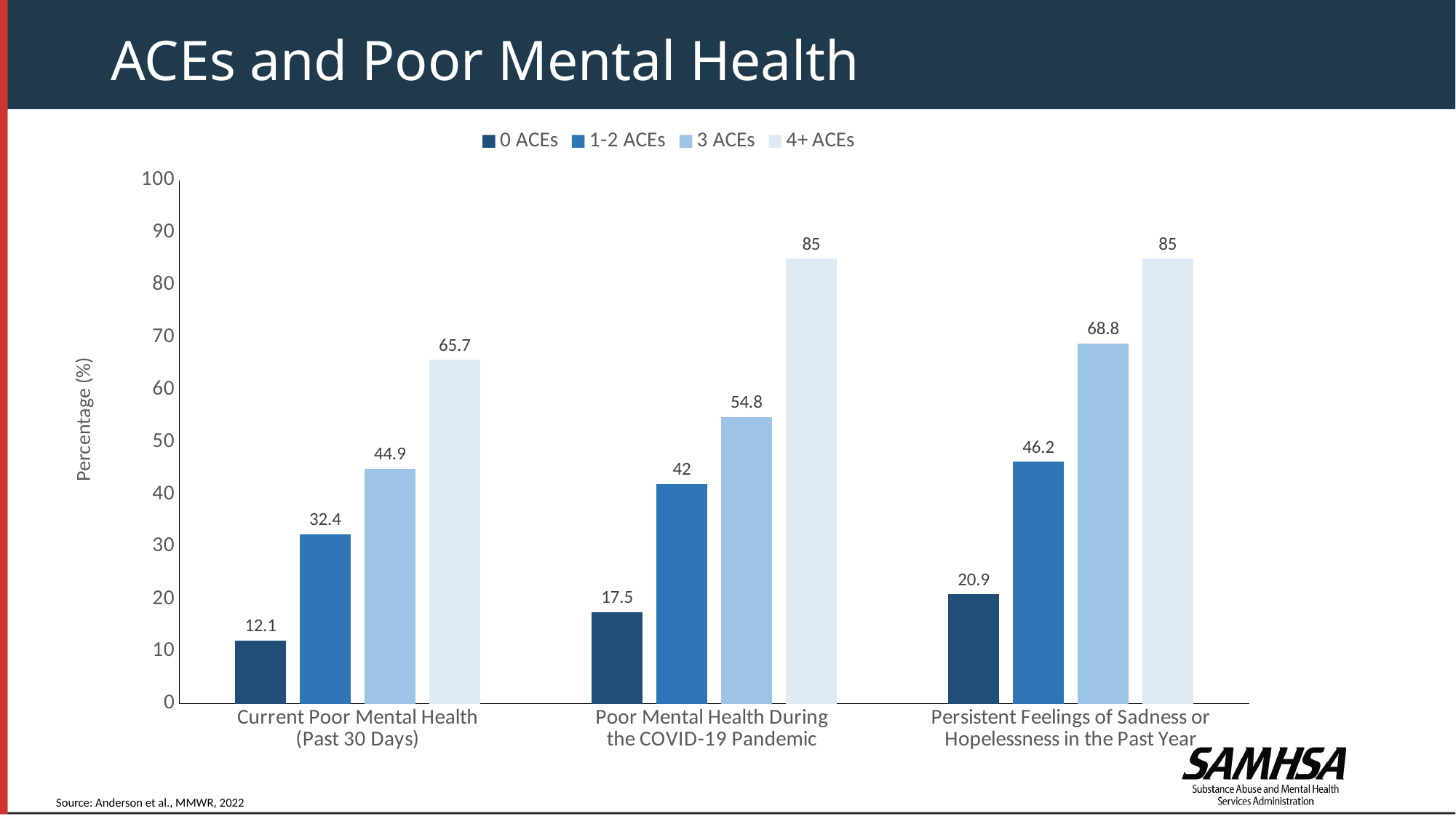
What is the value for 4+ ACEs in the Current Poor Mental Health (Past 30 Days) category? 65.7 What is the difference between the 4+ ACEs and 0 ACEs values in the Poor Mental Health During the COVID-19 Pandemic category? 67.5 What is the label of the y axis? Percentage (%) What is the value for 3 ACEs in the Persistent Feelings of Sadness or Hopelessness in the Past Year category? 68.8 Which ACEs group has the highest value in the Current Poor Mental Health (Past 30 Days) category? 4+ ACEs What is the value for 0 ACEs in the Poor Mental Health During the COVID-19 Pandemic category? 17.5 Is the value for 3 ACEs in the Poor Mental Health During the COVID-19 Pandemic category greater or less than 50? greater How many series does the legend list? 4 Which ACEs group has the lowest value in the Persistent Feelings of Sadness or Hopelessness in the Past Year category? 0 ACEs What kind of chart is shown on the slide? Bar chart Which is larger: the 1-2 ACEs value for Current Poor Mental Health (Past 30 Days) or the 1-2 ACEs value for Persistent Feelings of Sadness or Hopelessness in the Past Year? Persistent Feelings of Sadness or Hopelessness in the Past Year How many categories are shown on the x axis? 3